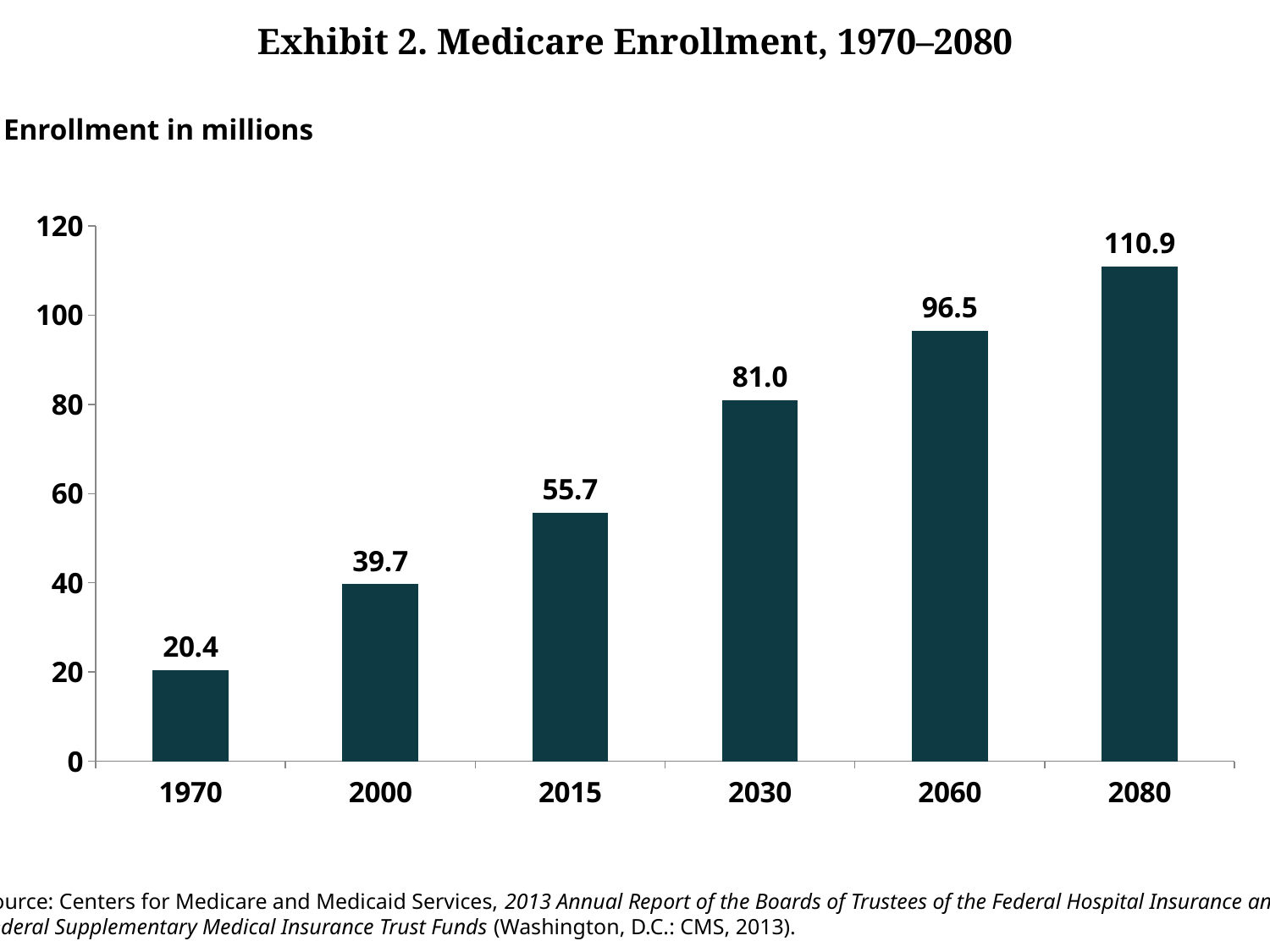
What is the Medicare enrollment value shown for 2060? 96.5 What is the difference between the enrollment values for 2080 and 2030? 29.9 Which year has the lowest Medicare enrollment on the chart? 1970 Which is larger, the enrollment value for 2030 or for 2060? 2060 Which year has the highest Medicare enrollment on the chart? 2080 What is the difference between the enrollment values for 2000 and 1970? 19.3 Do the enrollment values rise or fall from 1970 to 2080? Rise Is the enrollment value for 2080 greater or less than 100? greater What is the Medicare enrollment value shown for 2015? 55.7 What kind of chart is shown on the slide? Bar chart How many years are shown on the x axis of the chart? 6 What is the Medicare enrollment value shown for 1970? 20.4